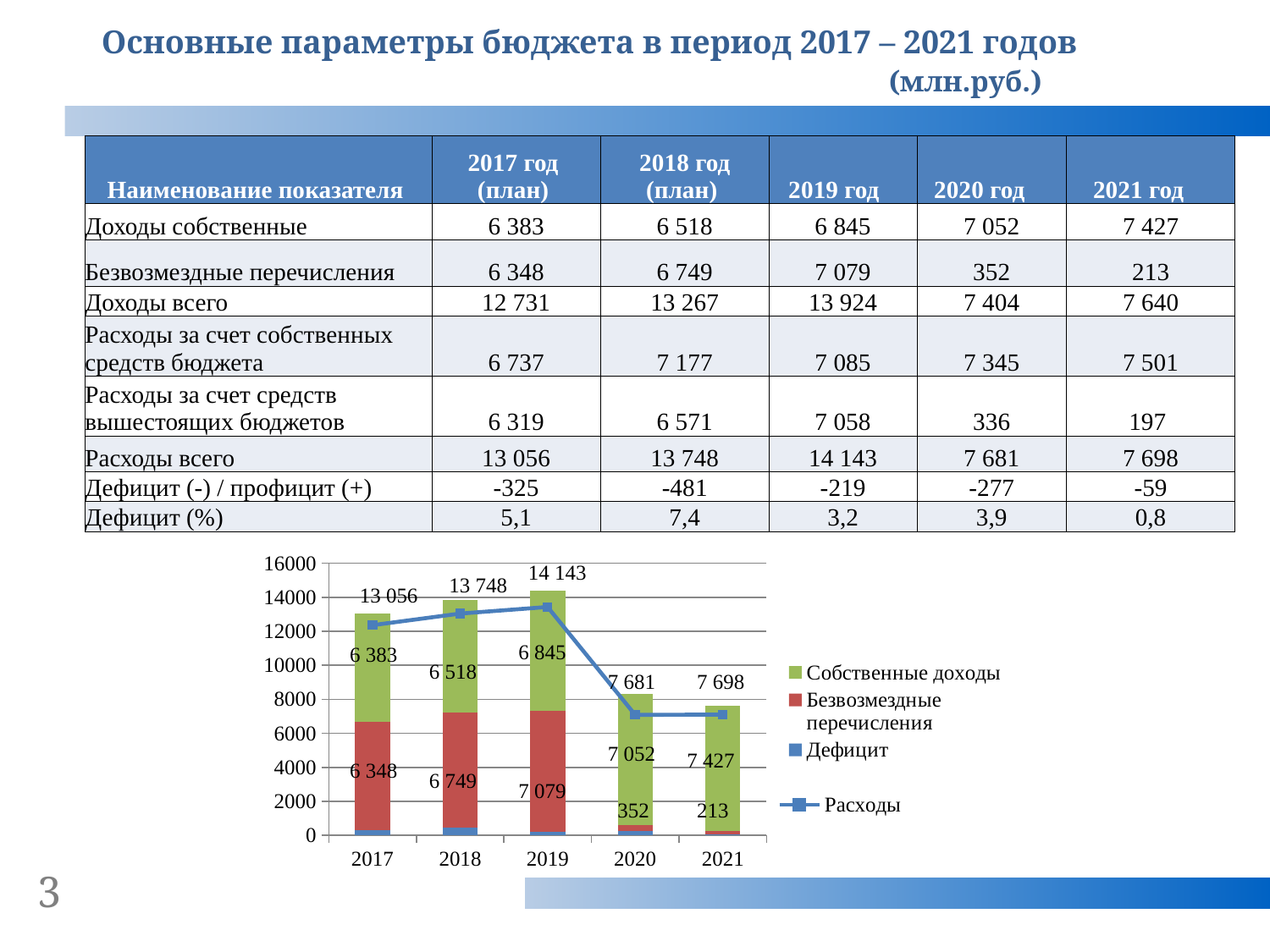
How many series does the chart legend list? 4 Which colour represents Собственные доходы in the chart? Green In which year is the Расходы line at its highest in the chart? 2019 In which year is Безвозмездные перечисления lowest in the chart? 2021 What type of chart is shown on the slide? Stacked bar chart with a line What is the value of Собственные доходы for 2019 in the chart? 6 845 Does the Расходы line rise or fall from 2019 to 2020 in the chart? Fall What is the value of Безвозмездные перечисления for 2018 in the chart? 6 749 What is the difference between Собственные доходы in 2019 and in 2017 in the chart? 462 Which is larger in the chart: Безвозмездные перечисления in 2019 or Собственные доходы in 2019? Безвозмездные перечисления in 2019 How many years are shown on the x axis of the chart? 5 What is the value of the Расходы line for 2020 in the chart? 7 681